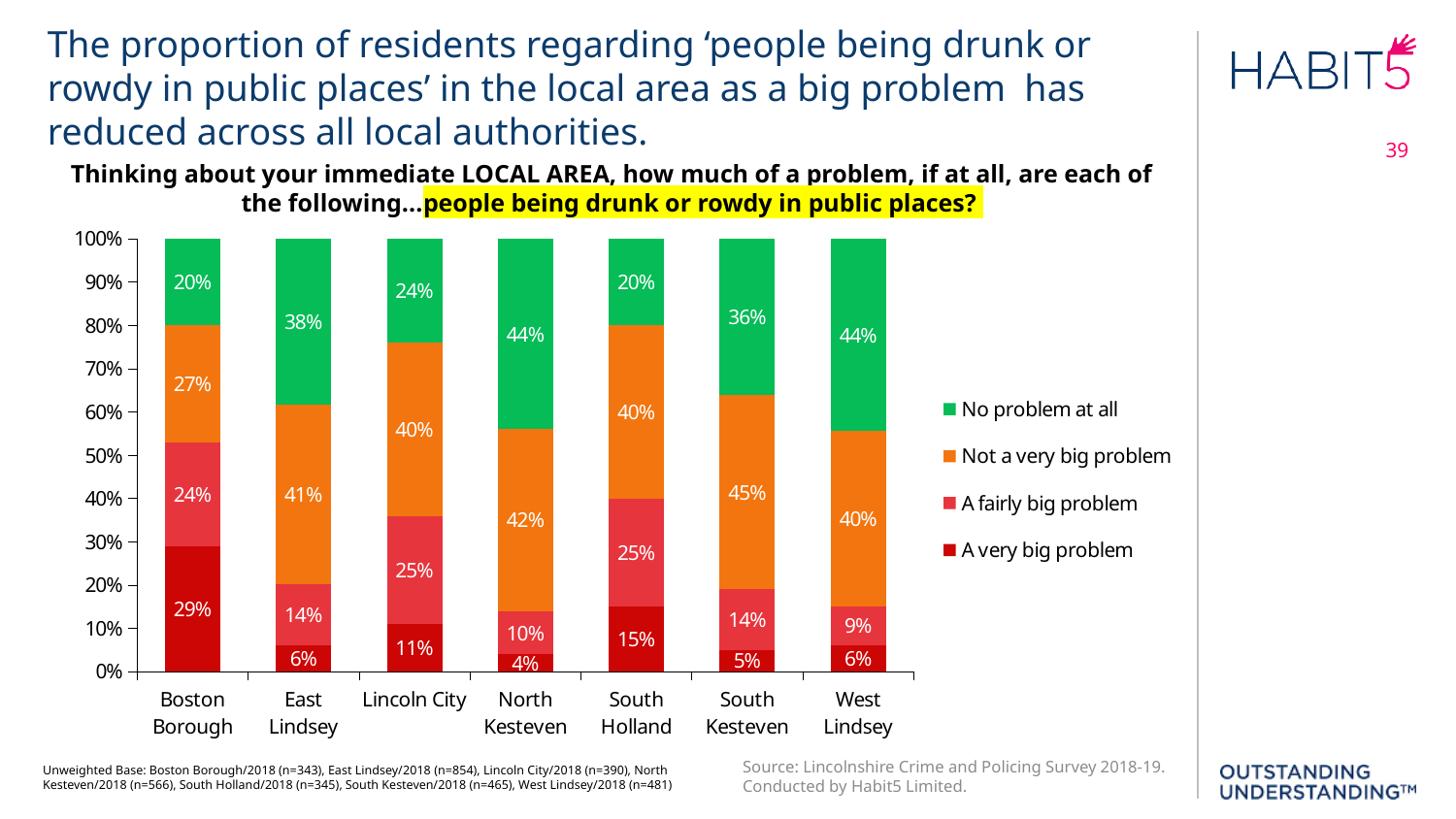
What is the combined percentage of Boston Borough residents who said 'A very big problem' or 'A fairly big problem'? 53% What kind of chart is shown on the slide? Stacked bar chart Which local authority has the lowest proportion of residents saying 'A very big problem'? North Kesteven What is the 'Not a very big problem' value for South Kesteven? 45% How many percentage points higher is the 'A very big problem' value for Boston Borough than for South Holland? 14 percentage points How many series does the chart's legend list? 4 How many local authorities are shown on the x axis of the chart? 7 Which has a larger 'No problem at all' value, East Lindsey or South Kesteven? East Lindsey What colour represents 'No problem at all' in the chart? Green Which local authority has the highest proportion of residents saying 'A very big problem'? Boston Borough What percentage of Boston Borough residents regard people being drunk or rowdy in public places as 'A very big problem'? 29% What percentage of North Kesteven residents said 'No problem at all'? 44%